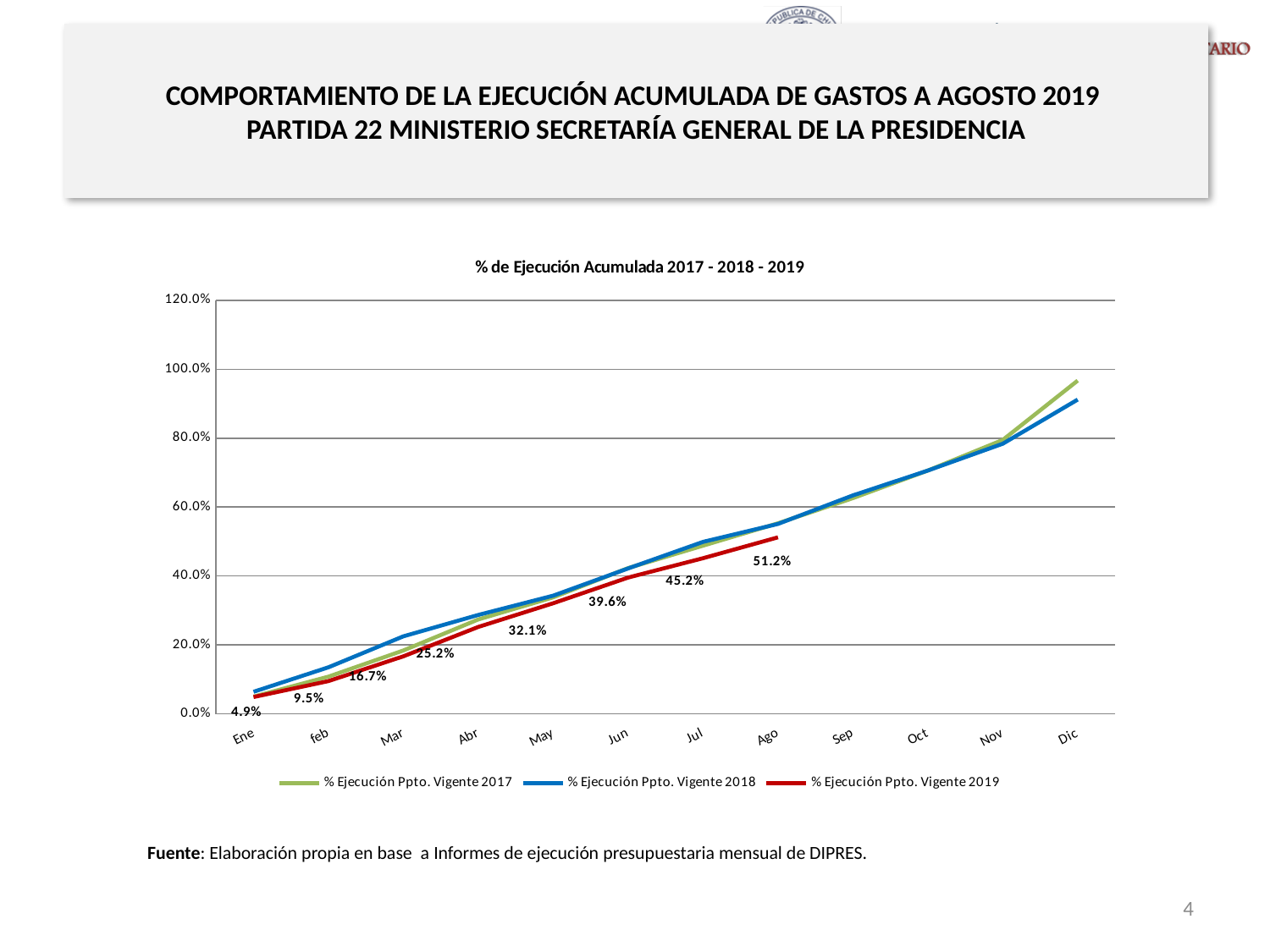
What is the difference between the % Ejecución Ppto. Vigente 2019 values for Abr and Mar? 8.5% How many months are shown on the x axis? 12 What kind of chart is shown on the slide? Line chart What is the value for % Ejecución Ppto. Vigente 2019 in Ene? 4.9% How many series does the legend list? 3 What is the difference between the % Ejecución Ppto. Vigente 2019 values for Ago and Jul? 6.0% What is the value for % Ejecución Ppto. Vigente 2019 in May? 32.1% In which month does the % Ejecución Ppto. Vigente 2019 series have its lowest value? Ene Is the value for % Ejecución Ppto. Vigente 2017 in Dic greater or less than 80.0%? greater What is the value for % Ejecución Ppto. Vigente 2019 in Jun? 39.6% What is the value for % Ejecución Ppto. Vigente 2019 in Ago? 51.2% In which month does the % Ejecución Ppto. Vigente 2019 series reach its highest value? Ago